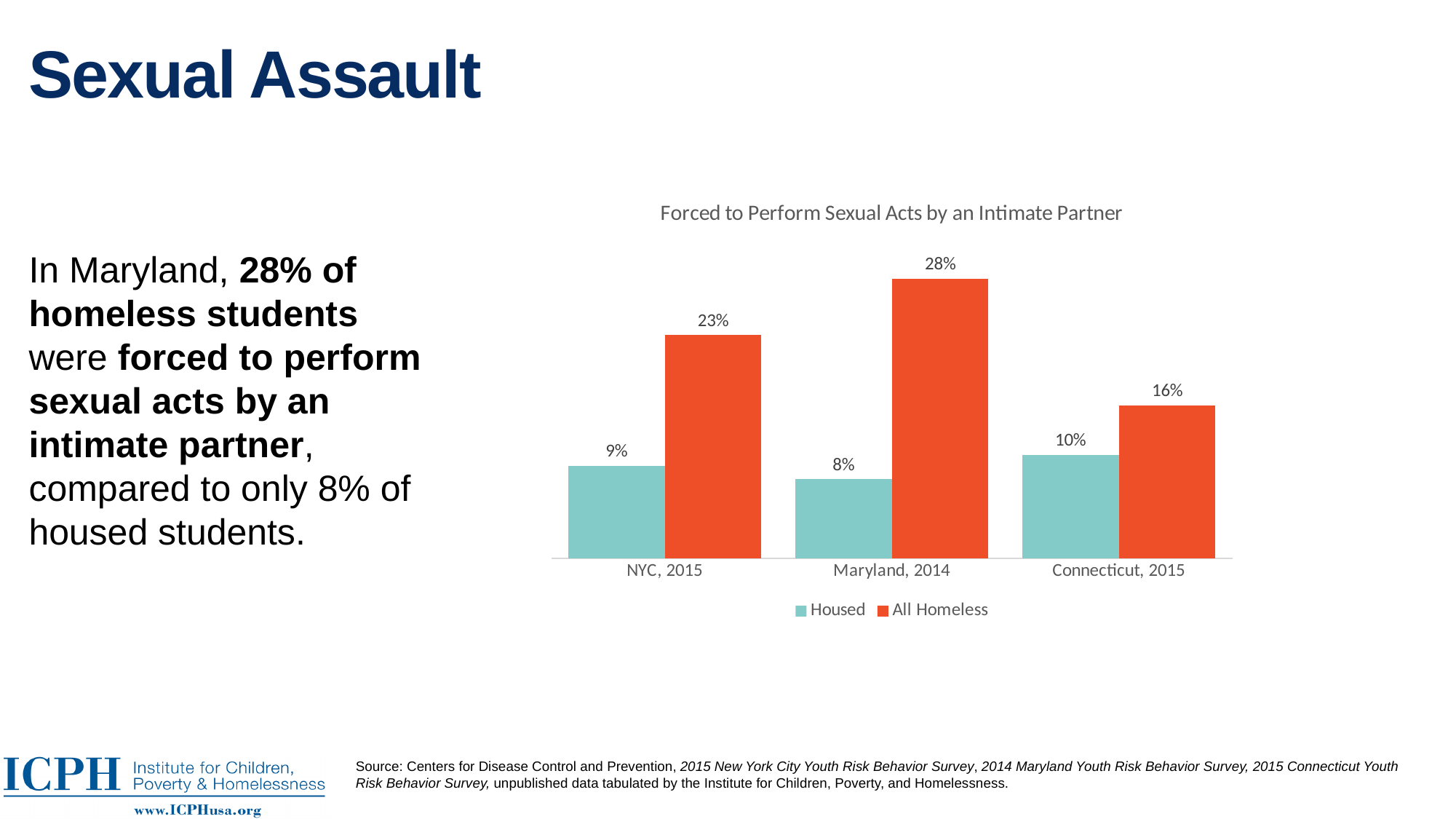
What is the difference between the All Homeless and Housed values in Maryland, 2014? 20% What is the value for All Homeless in Connecticut, 2015? 16% Which category has the highest All Homeless value? Maryland, 2014 What is the value for All Homeless in Maryland, 2014? 28% How many categories are shown on the x axis? 3 How many series does the legend list? 2 What kind of chart is shown on the slide? Bar chart Which category has the lowest Housed value? Maryland, 2014 What is the difference between the All Homeless values for NYC, 2015 and Connecticut, 2015? 7% Which is larger: the All Homeless value for NYC, 2015 or for Connecticut, 2015? NYC, 2015 What is the value for Housed in Connecticut, 2015? 10% What is the value for Housed in NYC, 2015? 9%